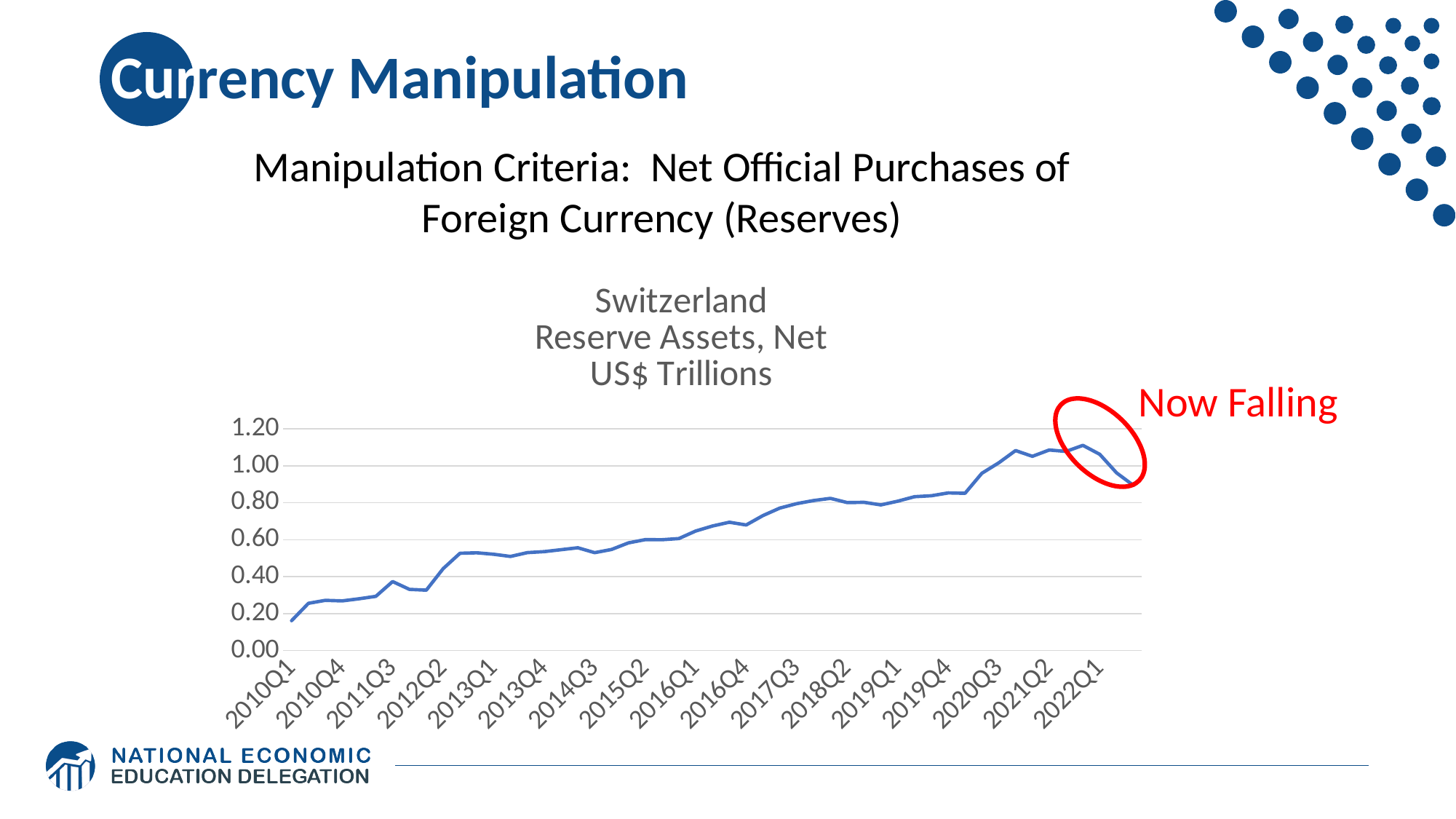
Is the value for 2014Q3 greater or less than 0.40? greater Overall, do the values rise or fall from 2010Q1 to 2021Q2? rise How many quarter labels are shown on the x axis? 17 Is the value for 2010Q1 greater or less than 0.20? less What does the red annotation next to the circled end of the line say? Now Falling What is the title of the chart? Switzerland Reserve Assets, Net US$ Trillions Is the value for 2021Q2 greater or less than 1.00? greater What kind of chart is shown on the slide? line chart Which is larger, the value for 2010Q1 or the value for 2022Q1? 2022Q1 Which is larger, the value for 2013Q1 or the value for 2019Q1? 2019Q1